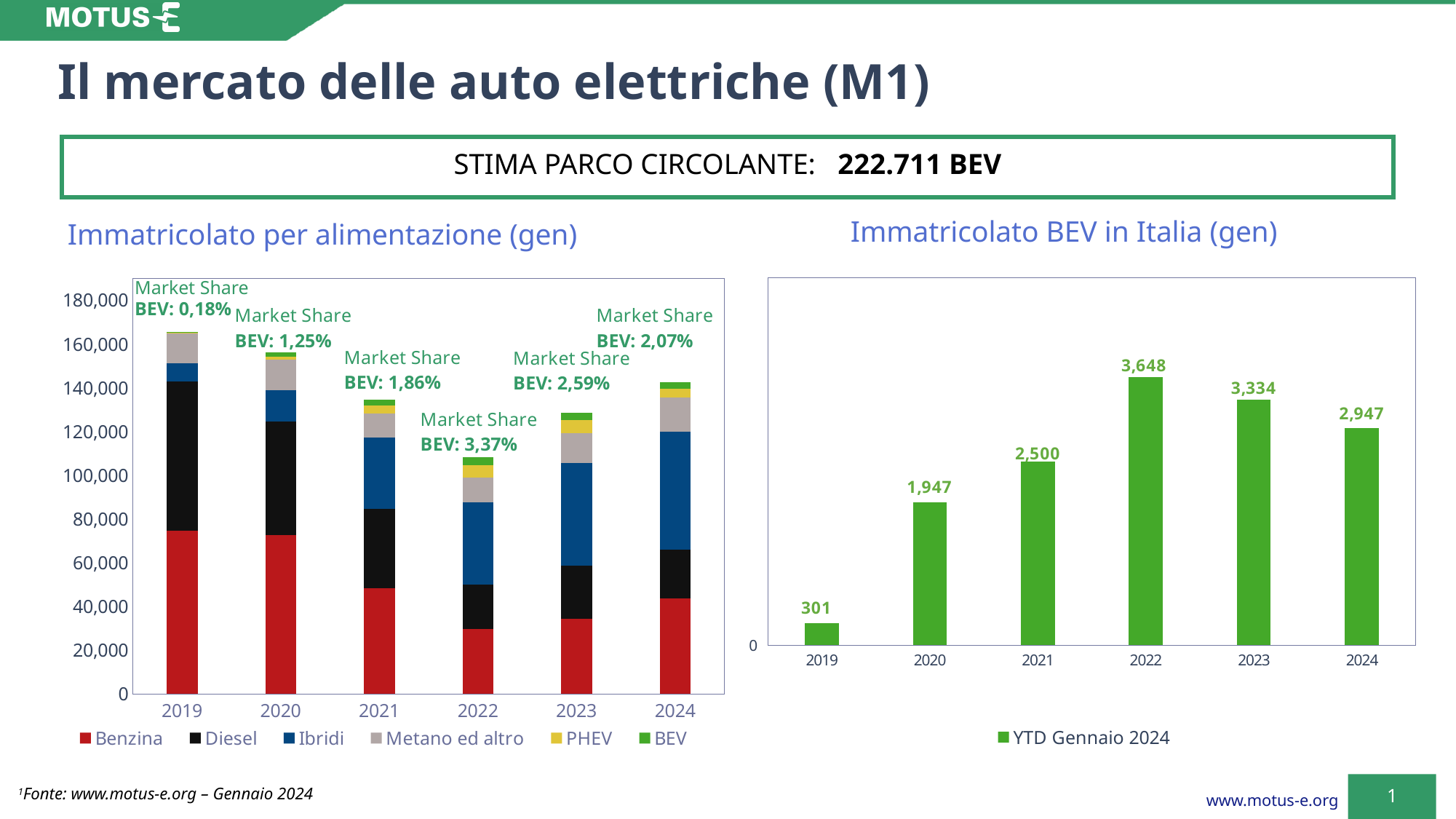
In the chart 'Immatricolato BEV in Italia (gen)', how many years are shown on the x axis? 6 In the chart 'Immatricolato BEV in Italia (gen)', what is the value for 2022? 3,648 In the chart 'Immatricolato BEV in Italia (gen)', do the values rise or fall from 2022 to 2024? fall What kind of chart is 'Immatricolato per alimentazione (gen)'? stacked bar chart In the chart 'Immatricolato per alimentazione (gen)', is the total of the stacked bar for 2019 greater or less than 160,000? greater In the chart 'Immatricolato BEV in Italia (gen)', which is larger, the value for 2020 or the value for 2021? 2021 In the chart 'Immatricolato per alimentazione (gen)', what is the BEV market share shown for 2022? 3,37% In the chart 'Immatricolato BEV in Italia (gen)', what is the difference between the values for 2023 and 2024? 387 In the chart 'Immatricolato per alimentazione (gen)', how many series does the legend list? 6 In the chart 'Immatricolato BEV in Italia (gen)', which year has the highest value? 2022 In the chart 'Immatricolato BEV in Italia (gen)', which year has the lowest value? 2019 In the chart 'Immatricolato BEV in Italia (gen)', what is the value for 2019? 301